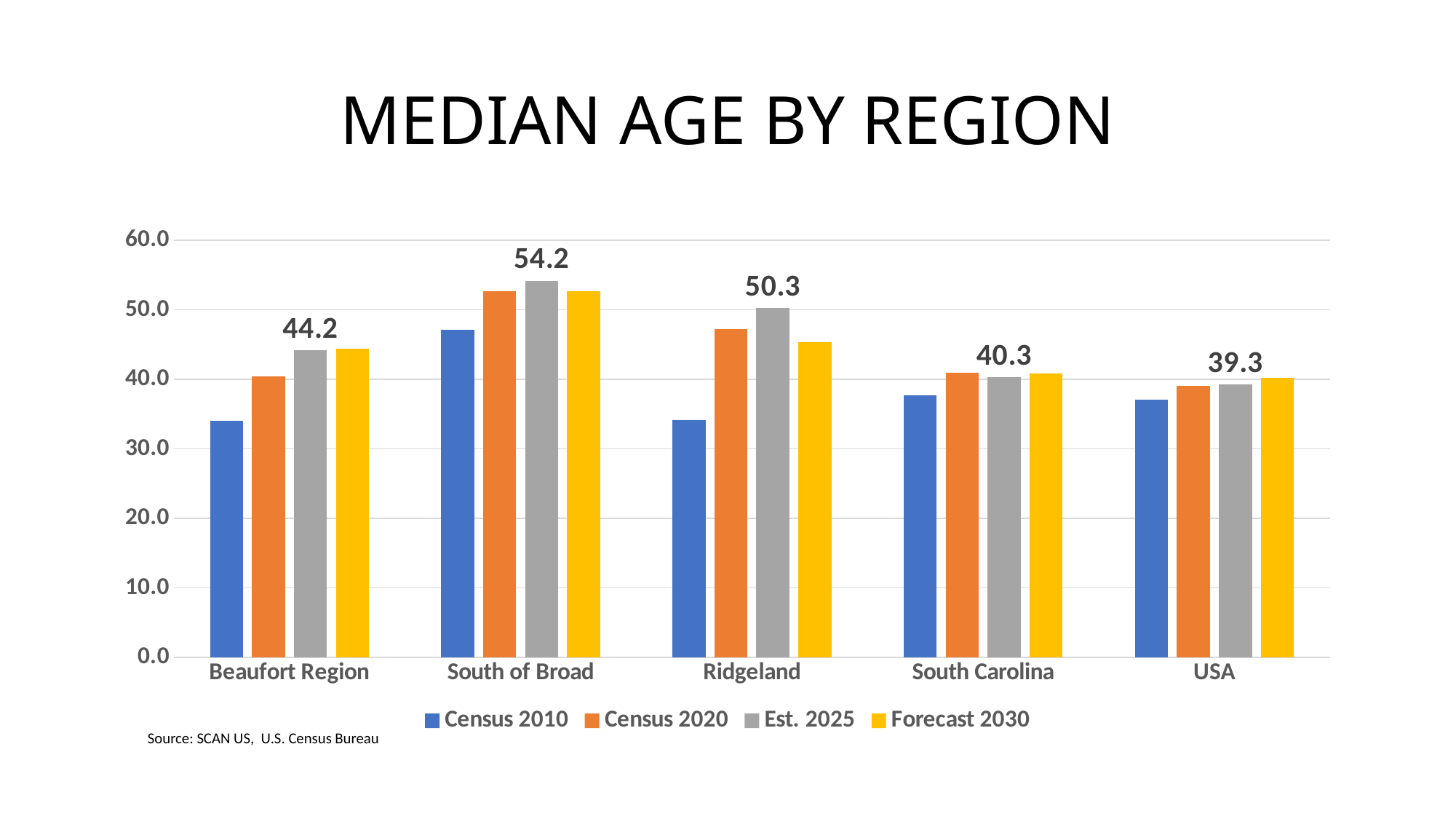
What kind of chart is shown on the slide? bar chart Which region has the lowest Est. 2025 median age? USA How many regions are shown on the x axis? 5 What is the difference between the Est. 2025 median age for South of Broad and for Beaufort Region? 10.0 How many series does the legend list? 4 What is the Est. 2025 median age for Beaufort Region? 44.2 Which region has the highest Est. 2025 median age? South of Broad Is the Census 2010 value for Beaufort Region greater or less than 40.0? less Which has a higher Est. 2025 median age, Ridgeland or South Carolina? Ridgeland What is the Est. 2025 median age for the USA? 39.3 What is the Est. 2025 median age for Ridgeland? 50.3 What is the Est. 2025 median age for South of Broad? 54.2